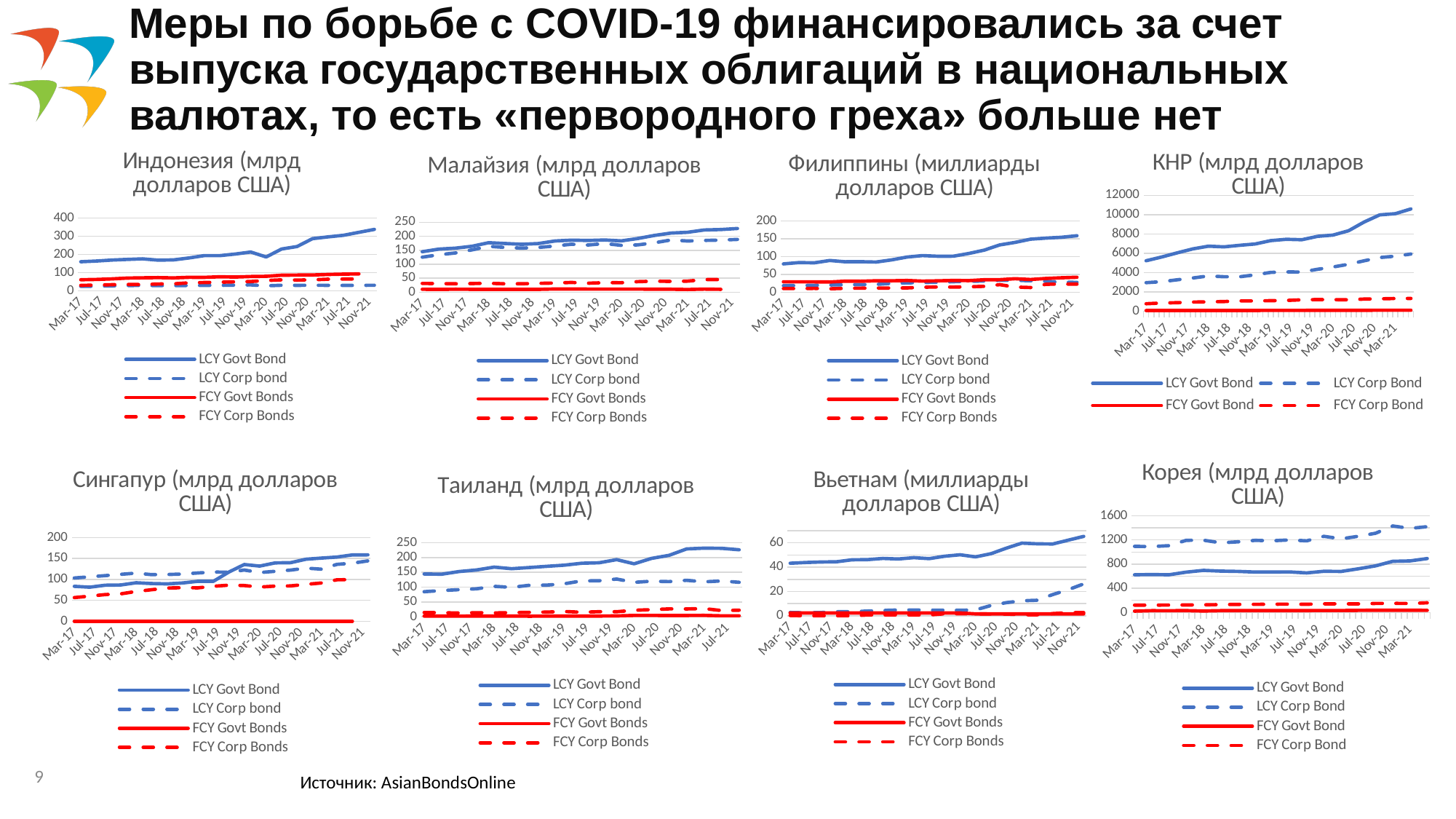
In the Корея (млрд долларов США) chart, is the value of LCY Corp Bond at Mar-17 greater or less than 800? greater In the Филиппины (миллиарды долларов США) chart, is the value of LCY Govt Bond at Nov-21 greater or less than 100? greater What source is cited for the charts on the slide? AsianBondsOnline In the Индонезия (млрд долларов США) chart, does the LCY Govt Bond line rise or fall from Mar-17 to Nov-21? rise How many series does the legend of the Индонезия (млрд долларов США) chart list? 4 In the Вьетнам (миллиарды долларов США) chart, does the LCY Corp bond line rise or fall from Mar-17 to Nov-21? rise How many charts are shown on the slide? 8 What kind of chart is the Индонезия (млрд долларов США) chart? line chart In the Корея (млрд долларов США) chart, which series is higher at Mar-21: LCY Govt Bond or LCY Corp Bond? LCY Corp Bond In the Таиланд (млрд долларов США) chart, is the value of LCY Govt Bond at Jul-21 greater or less than 200? greater In the Сингапур (млрд долларов США) chart, which series is higher at Mar-17: LCY Govt Bond or LCY Corp bond? LCY Corp bond